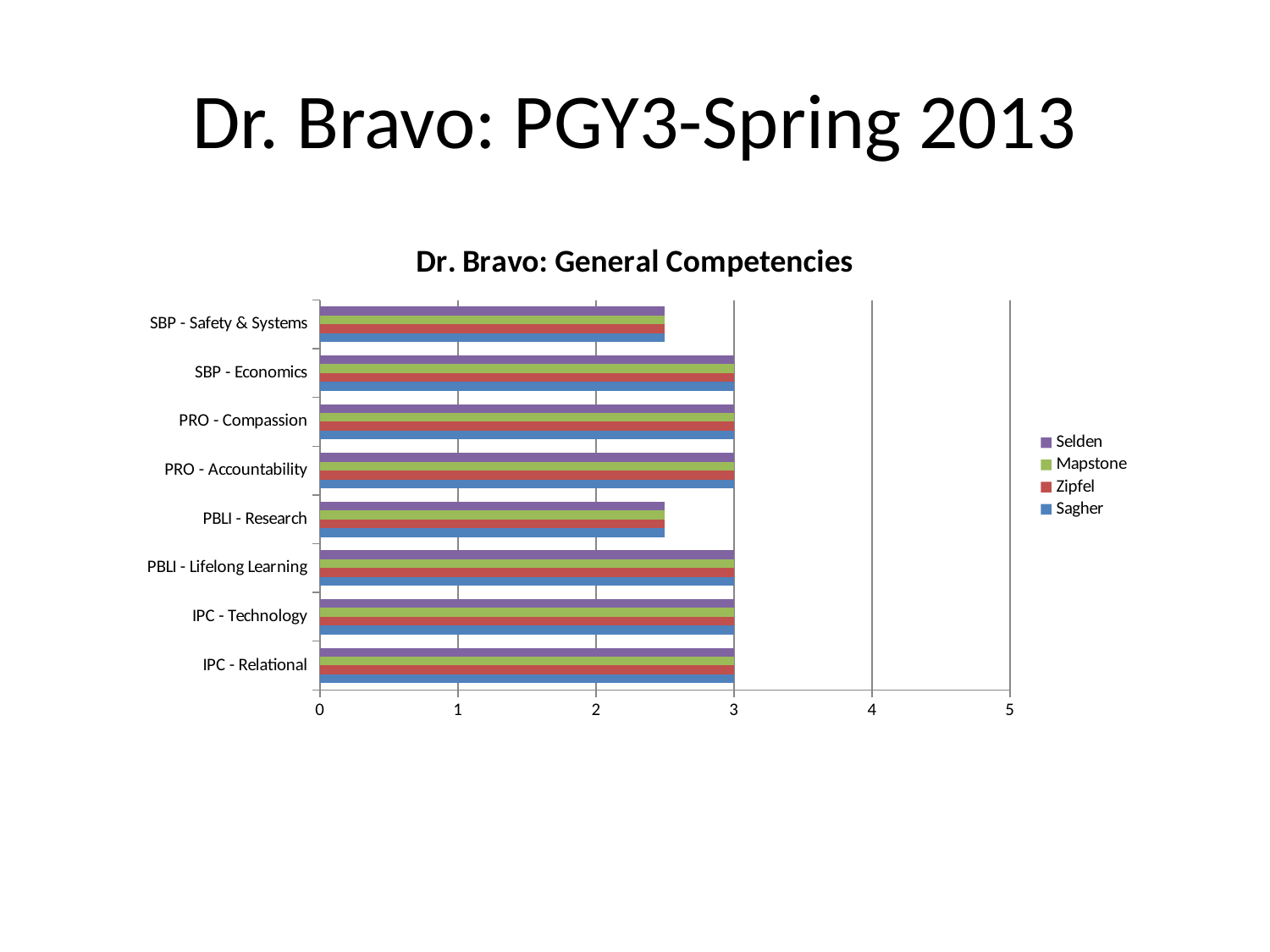
Which is larger: the value for Sagher in IPC - Technology or the value for Sagher in PBLI - Research? IPC - Technology What kind of chart is shown on the slide? bar chart What is the title of the chart? Dr. Bravo: General Competencies What is the value for Selden in the SBP - Economics category? 3 What is the value for Mapstone in the PRO - Compassion category? 3 Is the value for Selden in the SBP - Safety & Systems category greater or less than 2? greater Which is larger: the value for Mapstone in SBP - Safety & Systems or the value for Mapstone in SBP - Economics? SBP - Economics Is the value for Zipfel in the PBLI - Research category greater or less than 3? less What is the value for Sagher in the IPC - Relational category? 3 How many competency categories are shown on the chart? 8 How many series does the legend list? 4 Which series is listed first in the legend? Selden